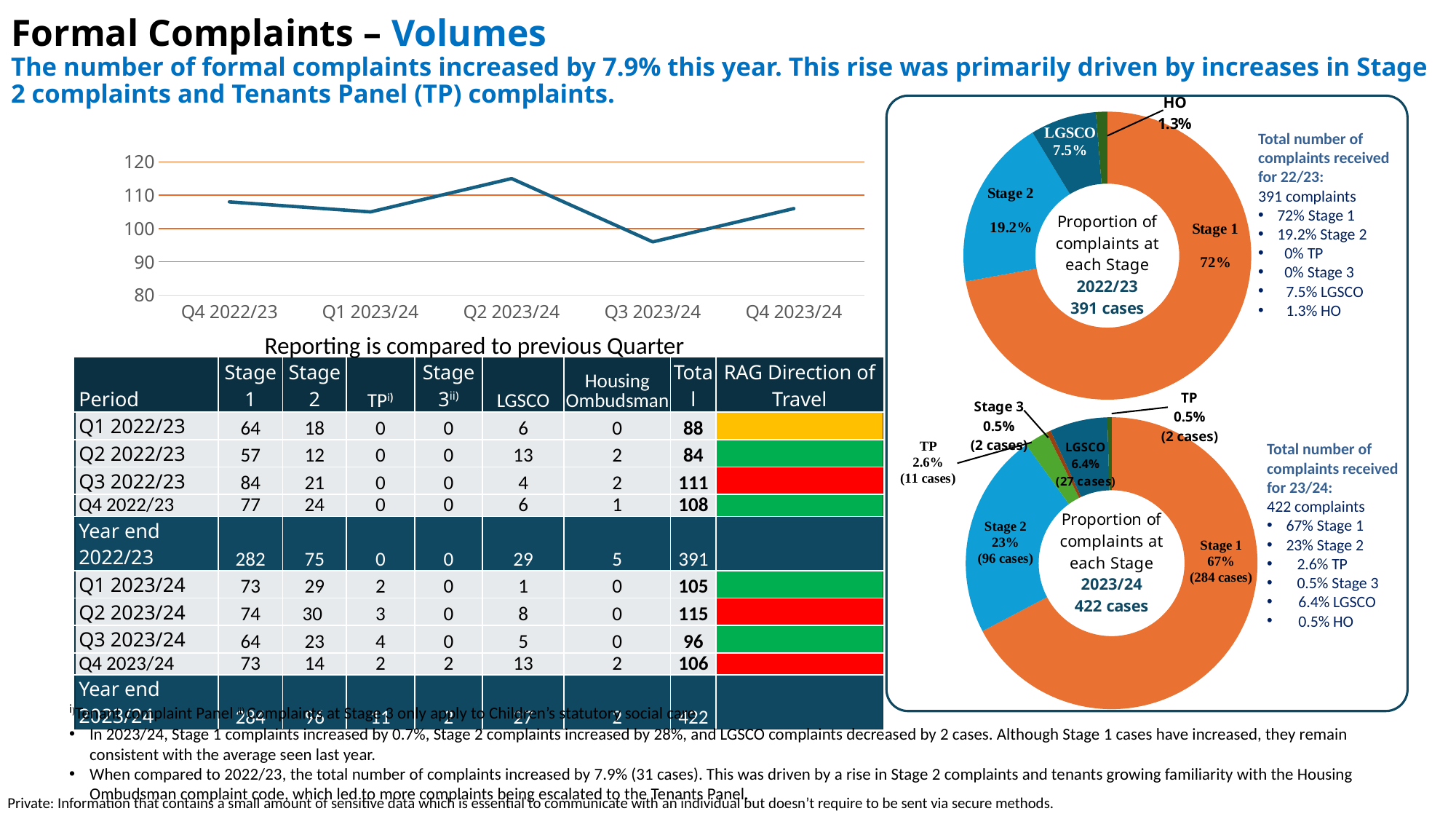
In the 2023/24 donut chart (Proportion of complaints at each Stage 2023/24), how many cases are Stage 2? 96 cases In the 2023/24 donut chart, what is the difference in cases between Stage 1 (284 cases) and Stage 2 (96 cases)? 188 In the 2022/23 donut chart (Proportion of complaints at each Stage 2022/23), what share of complaints is Stage 1? 72% In the line chart at the top left, is the value for Q2 2023/24 greater or less than 110? greater In the line chart at the top left, does the value rise or fall from Q2 2023/24 to Q3 2023/24? fall In the line chart at the top left, which quarter has the lowest value? Q3 2023/24 In the line chart at the top left, how many quarters are plotted along the x axis? 5 In the 2023/24 donut chart, which is larger, the Stage 2 share or the LGSCO share? Stage 2 What kind of chart is the chart at the top left of the slide showing quarterly totals from Q4 2022/23 to Q4 2023/24? line chart In the 2022/23 donut chart, what percentage of complaints is LGSCO? 7.5% In the line chart at the top left, which quarter has the highest value? Q2 2023/24 In the line chart at the top left, is the value for Q3 2023/24 greater or less than 100? less